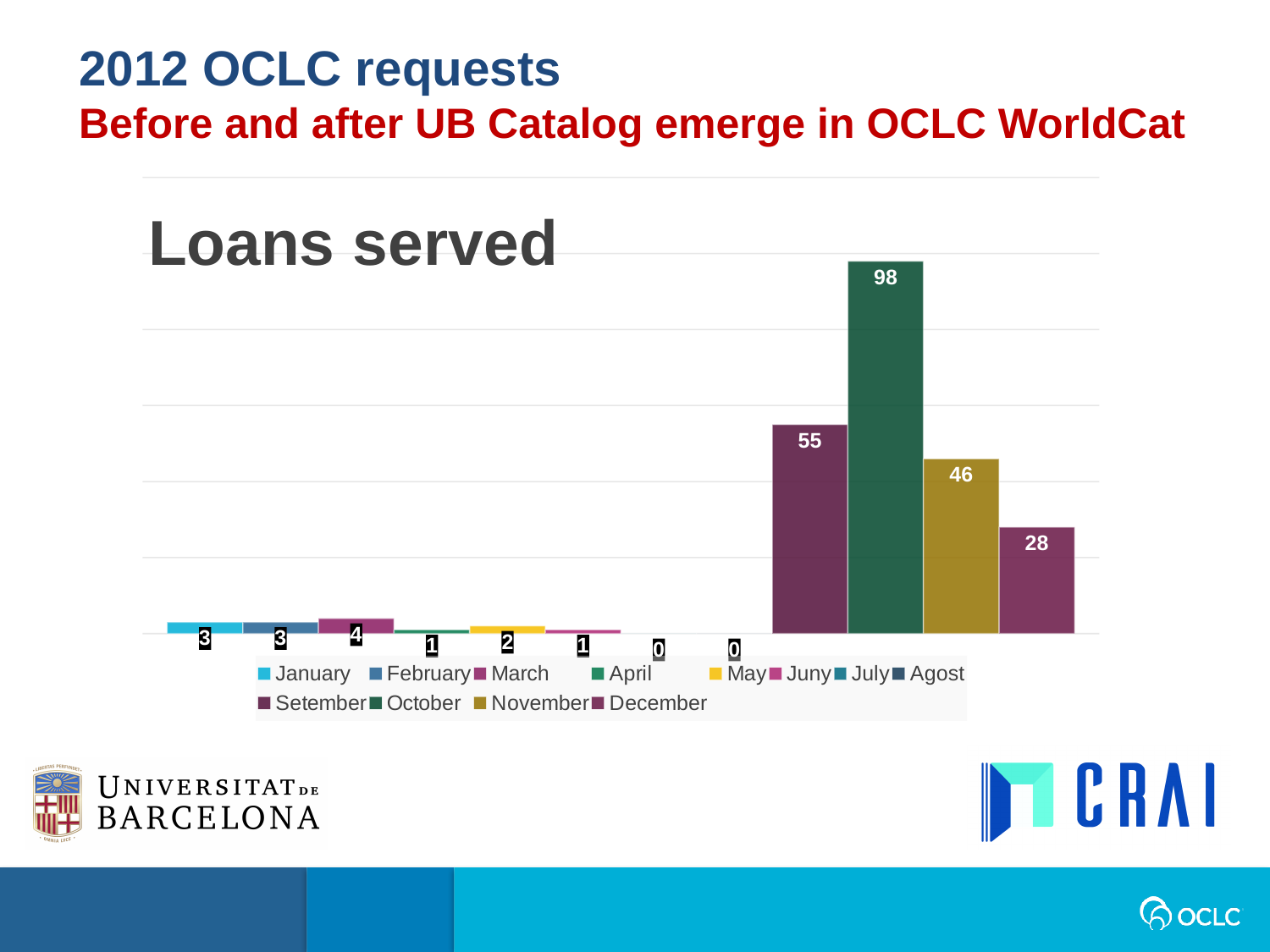
What is the title of the chart? Loans served Which is larger, the value for November or the value for December? November What is the value for November? 46 What is the difference between the values for November and December? 18 What is the value for October? 98 What kind of chart is shown on the slide? bar chart How many series does the legend list? 12 Which month has the highest value? October What is the value for Setember? 55 What is the value for December? 28 What is the value for March? 4 What is the difference between the values for October and Setember? 43